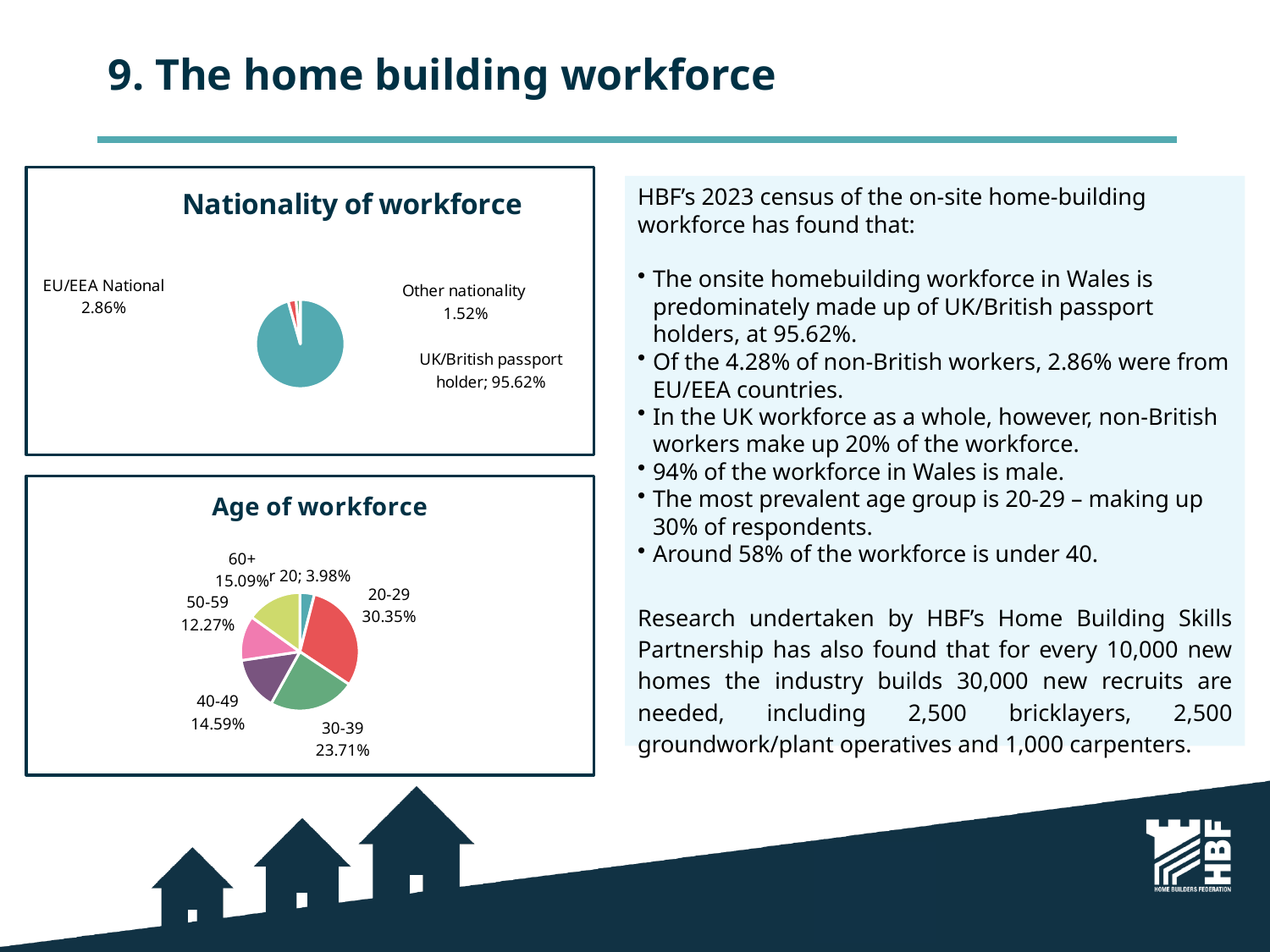
In the 'Age of workforce' chart, what percentage of the workforce is aged 30-39? 23.71% In the 'Nationality of workforce' chart, which category has the smallest share? Other nationality In the 'Age of workforce' chart, what percentage of the workforce is aged 20-29? 30.35% In the 'Nationality of workforce' chart, what percentage is labelled 'Other nationality'? 1.52% In the 'Age of workforce' chart, what percentage of the workforce is aged 60+? 15.09% In the 'Age of workforce' chart, what is the difference in percentage points between the 40-49 and 50-59 groups? 2.32 In the 'Nationality of workforce' chart, what percentage of the workforce are EU/EEA Nationals? 2.86% In the 'Nationality of workforce' chart, how many categories are shown? 3 What type of chart is the 'Age of workforce' chart? Pie chart In the 'Age of workforce' chart, which age group has the largest share? 20-29 In the 'Nationality of workforce' chart, what share of the workforce are UK/British passport holders? 95.62% In the 'Age of workforce' chart, which is larger: the share for 30-39 or the share for 60+? 30-39